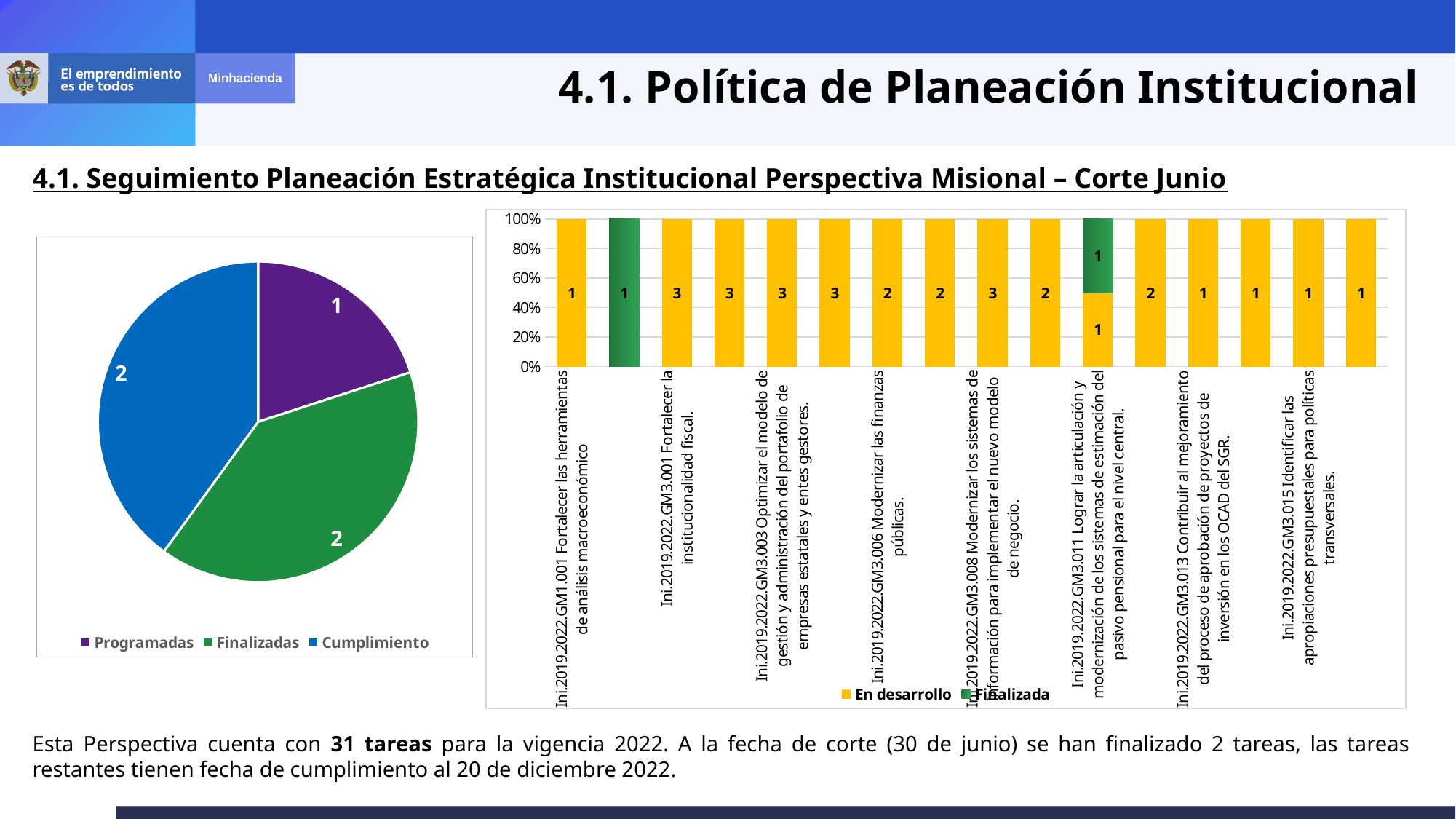
How many series does the legend of the bar chart on the right list? 2 In the bar chart on the right, what is the En desarrollo value for Ini.2019.2022.GM3.001 Fortalecer la institucionalidad fiscal? 3 In the pie chart on the left, which category has the smallest slice? Programadas In the pie chart on the left, what is the value for Programadas? 1 In the pie chart on the left, what share of the total does the Programadas slice represent? 20% In the bar chart on the right, what is the total of the stacked bar for Ini.2019.2022.GM3.011 Lograr la articulación y modernización de los sistemas de estimación del pasivo pensional para el nivel central? 2 In the pie chart on the left, what is the value for Finalizadas? 2 What kind of chart is the chart on the left of the slide? pie chart What kind of chart is the chart on the right of the slide? bar chart In the bar chart on the right, what is the Finalizada value for Ini.2019.2022.GM3.011 Lograr la articulación y modernización de los sistemas de estimación del pasivo pensional para el nivel central? 1 How many entries does the legend of the pie chart on the left list? 3 How many bars are plotted in the bar chart on the right? 16